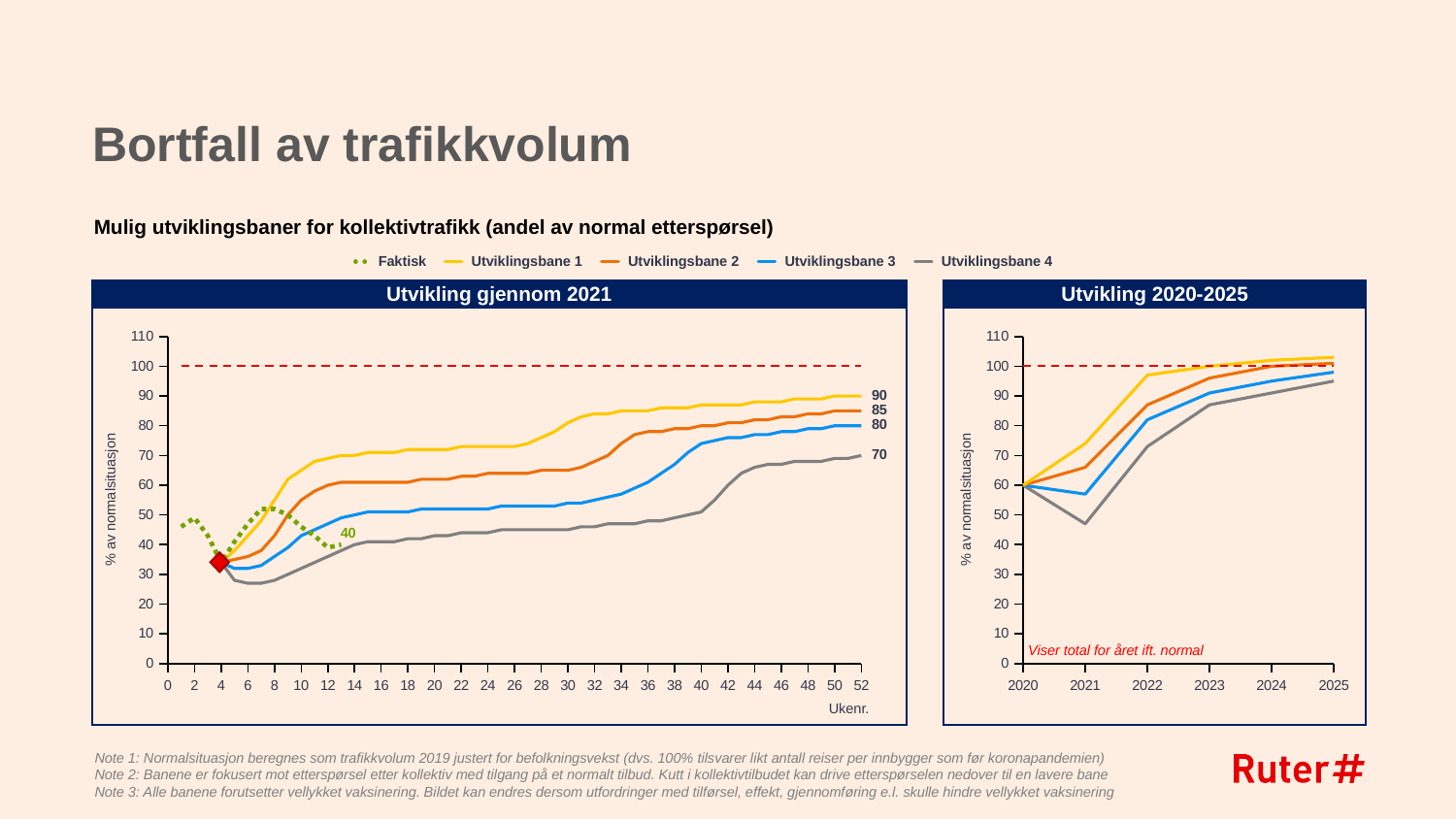
In the "Utvikling gjennom 2021" chart, which is larger at week 52: Utviklingsbane 2 or Utviklingsbane 3? Utviklingsbane 2 In the "Utvikling 2020-2025" chart, is the value for Utviklingsbane 1 in 2022 greater or less than 90? greater In the "Utvikling gjennom 2021" chart, what is the difference between the week-52 values of Utviklingsbane 1 and Utviklingsbane 4? 20 In the "Utvikling gjennom 2021" chart, which series has the highest value at week 52? Utviklingsbane 1 How many years are shown on the x axis of the "Utvikling 2020-2025" chart? 6 In the "Utvikling 2020-2025" chart, does Utviklingsbane 1 rise or fall from 2021 to 2025? Rise In the "Utvikling gjennom 2021" chart, which series has the lowest value at week 52? Utviklingsbane 4 How many series does the legend list for the charts? 5 In the "Utvikling gjennom 2021" chart, what value does Utviklingsbane 4 reach at week 52? 70 In the "Utvikling gjennom 2021" chart, what is the labelled value of the Faktisk series at its last point? 40 In the "Utvikling gjennom 2021" chart, what value does Utviklingsbane 1 reach at week 52? 90 What type of chart is the "Utvikling gjennom 2021" chart? Line chart